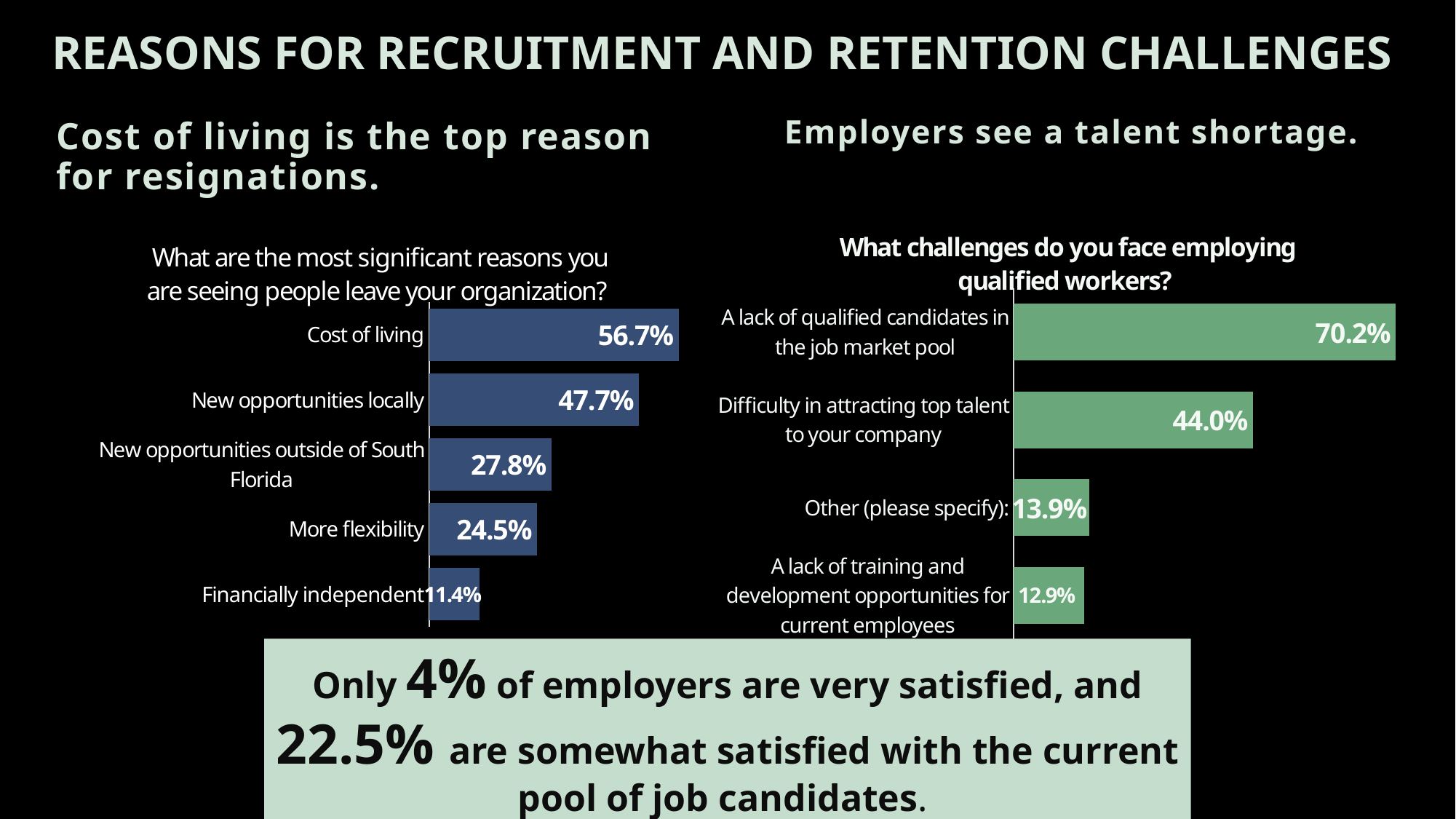
In the left chart (reasons people leave your organization), what is the value for Cost of living? 56.7% In the left chart (reasons people leave your organization), what is the difference between Cost of living and New opportunities locally? 9.0% In the right chart (challenges employing qualified workers), which category has the highest value? A lack of qualified candidates in the job market pool In the left chart (reasons people leave your organization), what is the value for More flexibility? 24.5% In the right chart (challenges employing qualified workers), which is larger: Other (please specify) or A lack of training and development opportunities for current employees? Other (please specify) In the left chart (reasons people leave your organization), which category has the lowest value? Financially independent In the right chart (challenges employing qualified workers), what is the value for Difficulty in attracting top talent to your company? 44.0% What is the title of the right chart? What challenges do you face employing qualified workers? In the right chart (challenges employing qualified workers), how many categories are shown? 4 In the left chart (reasons people leave your organization), how many categories are shown? 5 What type of chart is the left chart (reasons people leave your organization)? Bar chart In the right chart (challenges employing qualified workers), what is the difference between A lack of qualified candidates in the job market pool and Difficulty in attracting top talent to your company? 26.2%